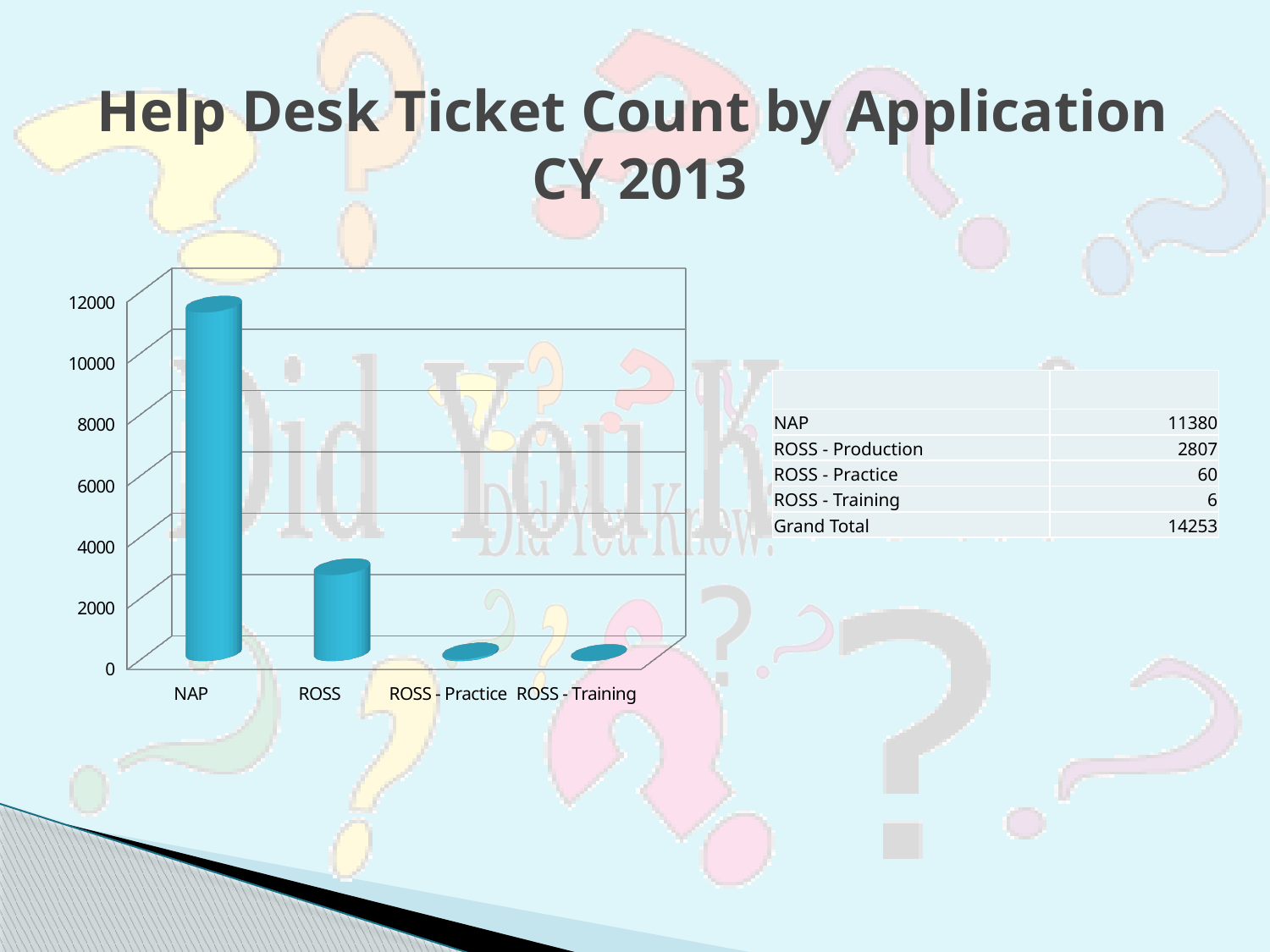
Which bar is taller, NAP or ROSS? NAP Is the value of the ROSS bar greater or less than 4000? less How many categories are plotted on the x axis of the chart? 4 Which application has the highest help desk ticket count in the chart? NAP What kind of chart is shown on the slide? bar chart Is the value of the NAP bar greater or less than 10000? greater What is the help desk ticket count for ROSS - Practice shown in the table? 60 Which application has the lowest help desk ticket count according to the slide? ROSS - Training What is the Grand Total of help desk tickets shown in the table? 14253 What is the help desk ticket count for NAP shown in the table? 11380 What is the help desk ticket count for ROSS - Production shown in the table? 2807 What is the help desk ticket count for ROSS - Training shown in the table? 6